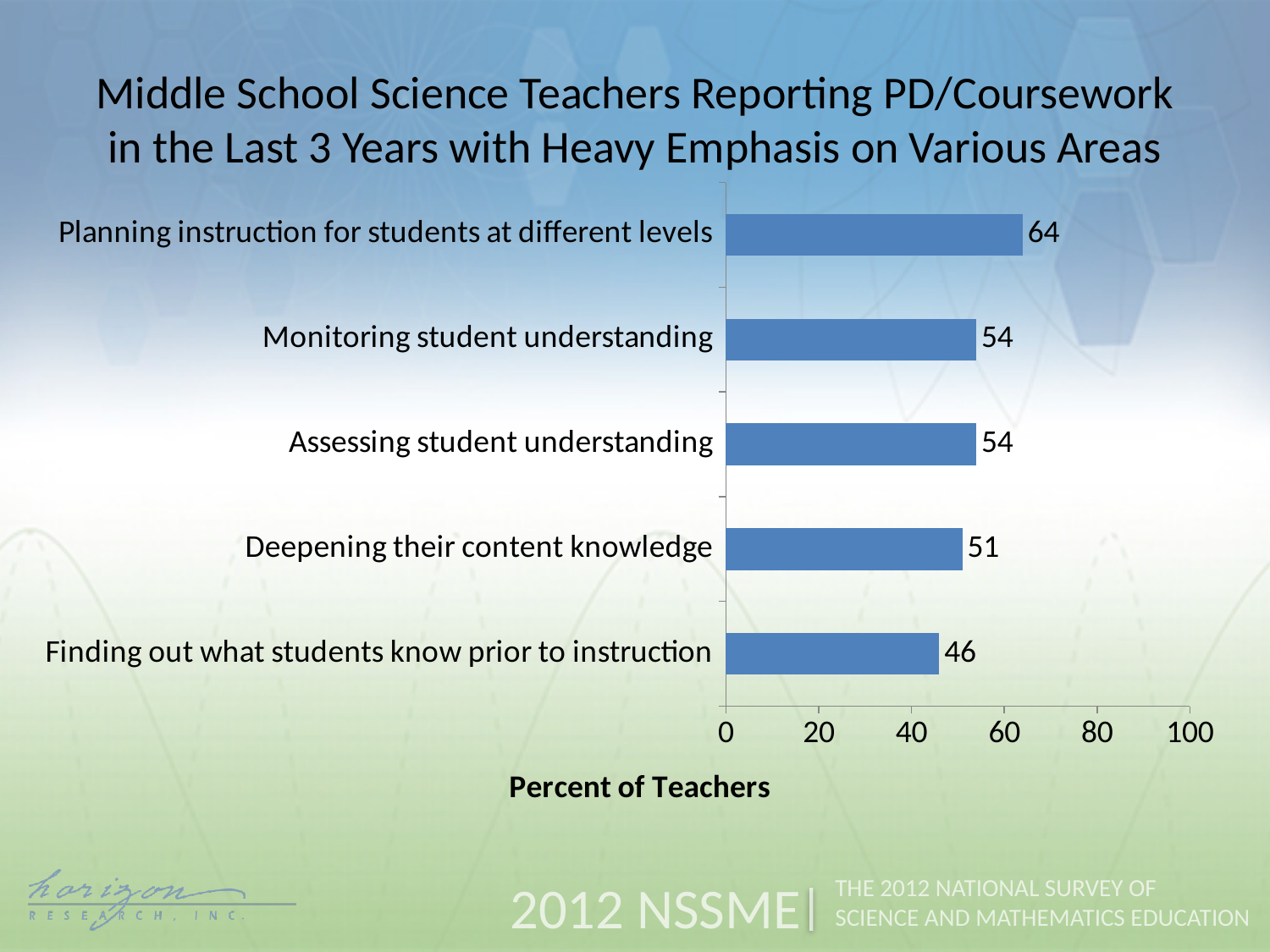
What is the value for 'Deepening their content knowledge'? 51 What kind of chart is shown on the slide? Bar chart Which area has the lowest percent of teachers? Finding out what students know prior to instruction Which area has the highest percent of teachers? Planning instruction for students at different levels What percent of teachers reported heavy emphasis on planning instruction for students at different levels? 64 What is the label of the horizontal axis? Percent of Teachers What is the difference between the values for 'Planning instruction for students at different levels' and 'Finding out what students know prior to instruction'? 18 How many areas (categories) are shown in the chart? 5 What is the value for 'Finding out what students know prior to instruction'? 46 Is the value for 'Assessing student understanding' greater or less than 40? greater What is the maximum value shown on the horizontal axis? 100 Which is larger: the value for 'Monitoring student understanding' or 'Deepening their content knowledge'? Monitoring student understanding